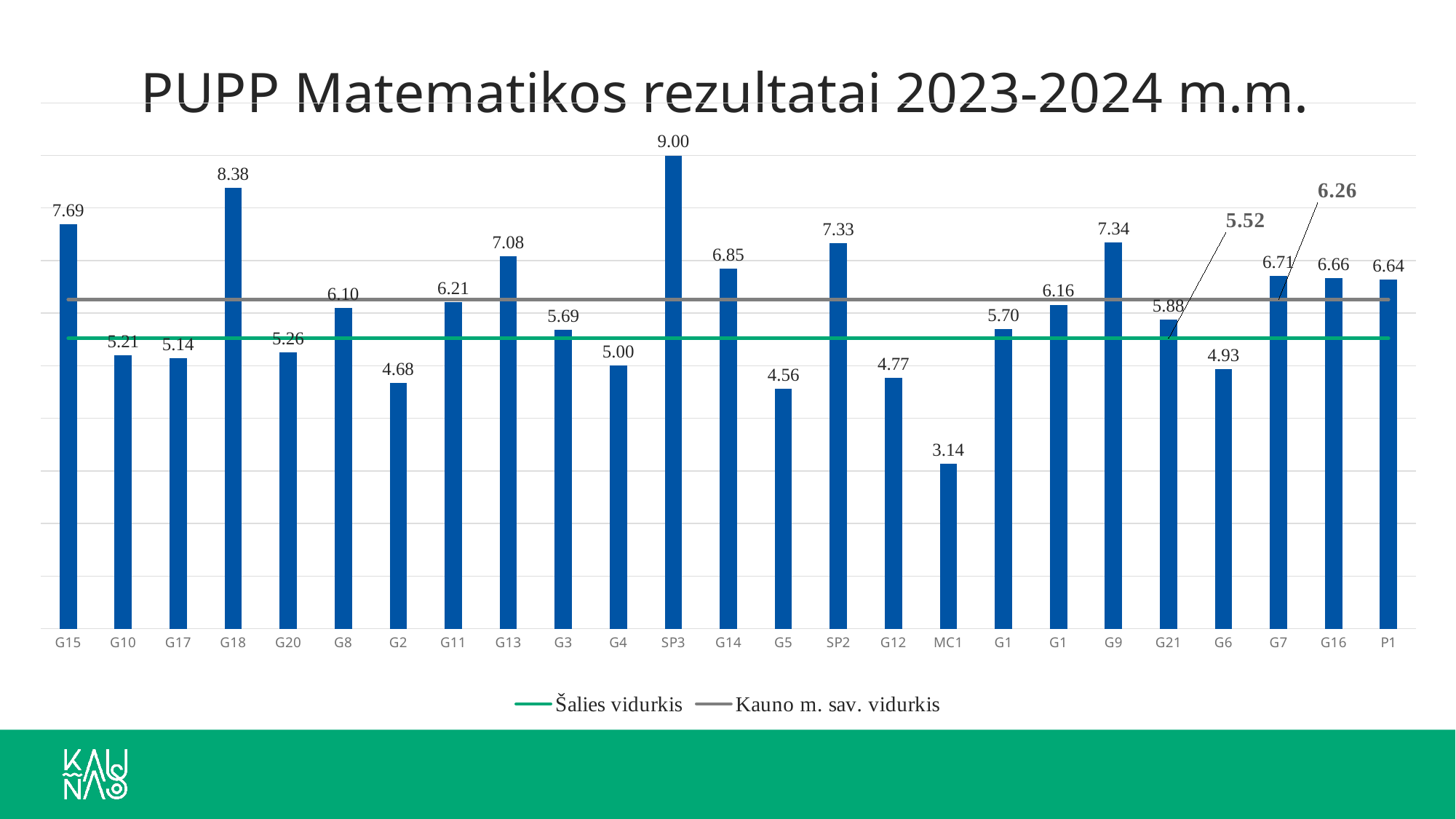
Which is larger, the value for G9 or the value for G13? G9 What is the value for SP3? 9.00 Which category has the highest value? SP3 What is the difference between the values for G18 and G15? 0.69 Which category has the lowest value? MC1 What is the value for G18? 8.38 What is the value for MC1? 3.14 What value is shown for the Šalies vidurkis line? 5.52 What kind of chart is shown on the slide? combination bar and line chart What is the title of the chart? PUPP Matematikos rezultatai 2023-2024 m.m. How many series does the legend list? 2 What value is shown for the Kauno m. sav. vidurkis line? 6.26